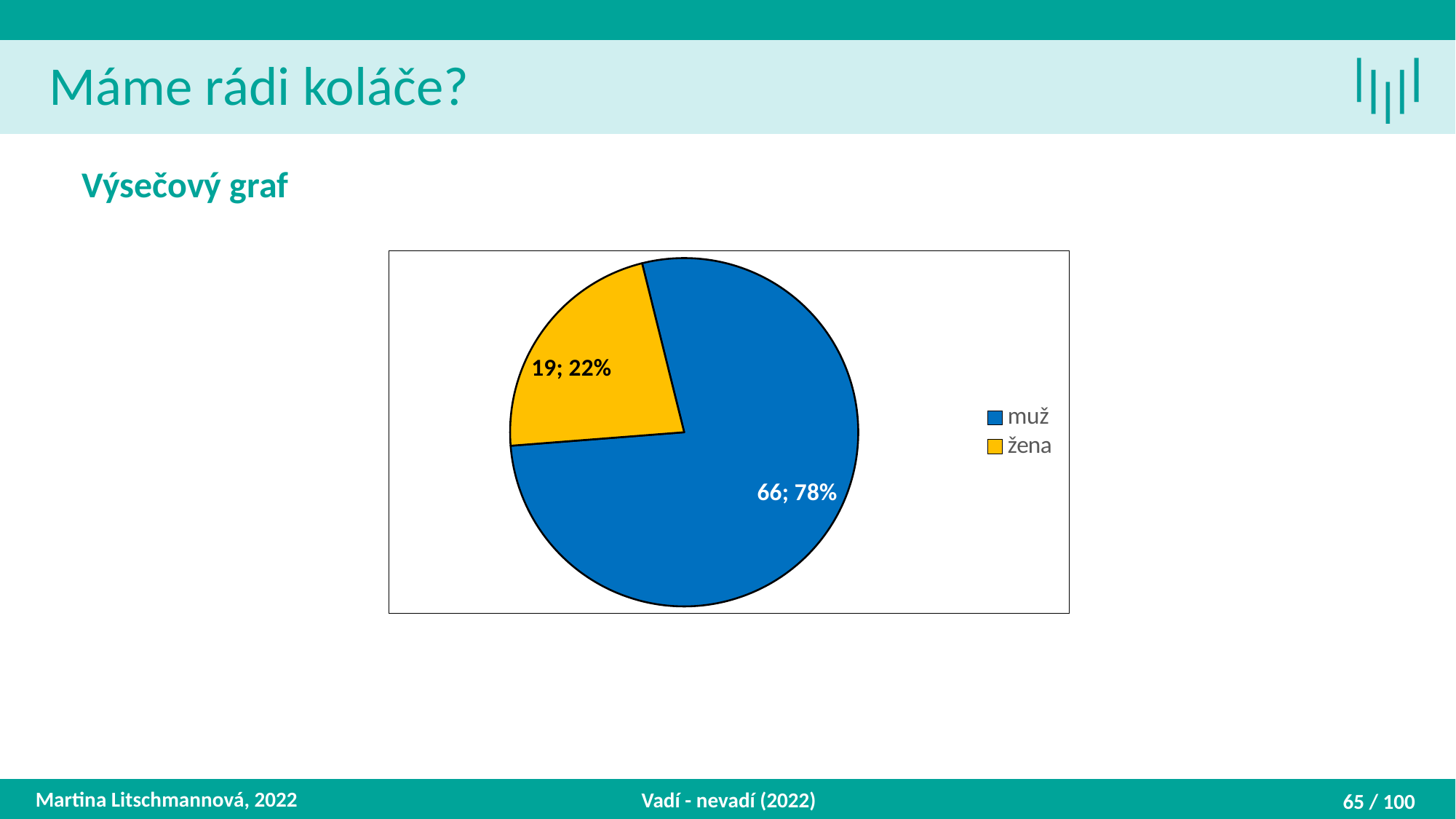
What share of the pie does the 'žena' slice represent? 22% What is the total count across both slices? 85 What kind of chart is shown on the slide? pie chart How many slices does the pie chart have? 2 Which category has the largest slice? muž What is the count shown for the 'žena' slice? 19 What is the count shown for the 'muž' slice? 66 What share of the pie does the 'muž' slice represent? 78% How many entries does the legend list? 2 What is the difference between the counts for 'muž' and 'žena'? 47 What colour is the 'žena' slice? yellow Which category has the smallest slice? žena